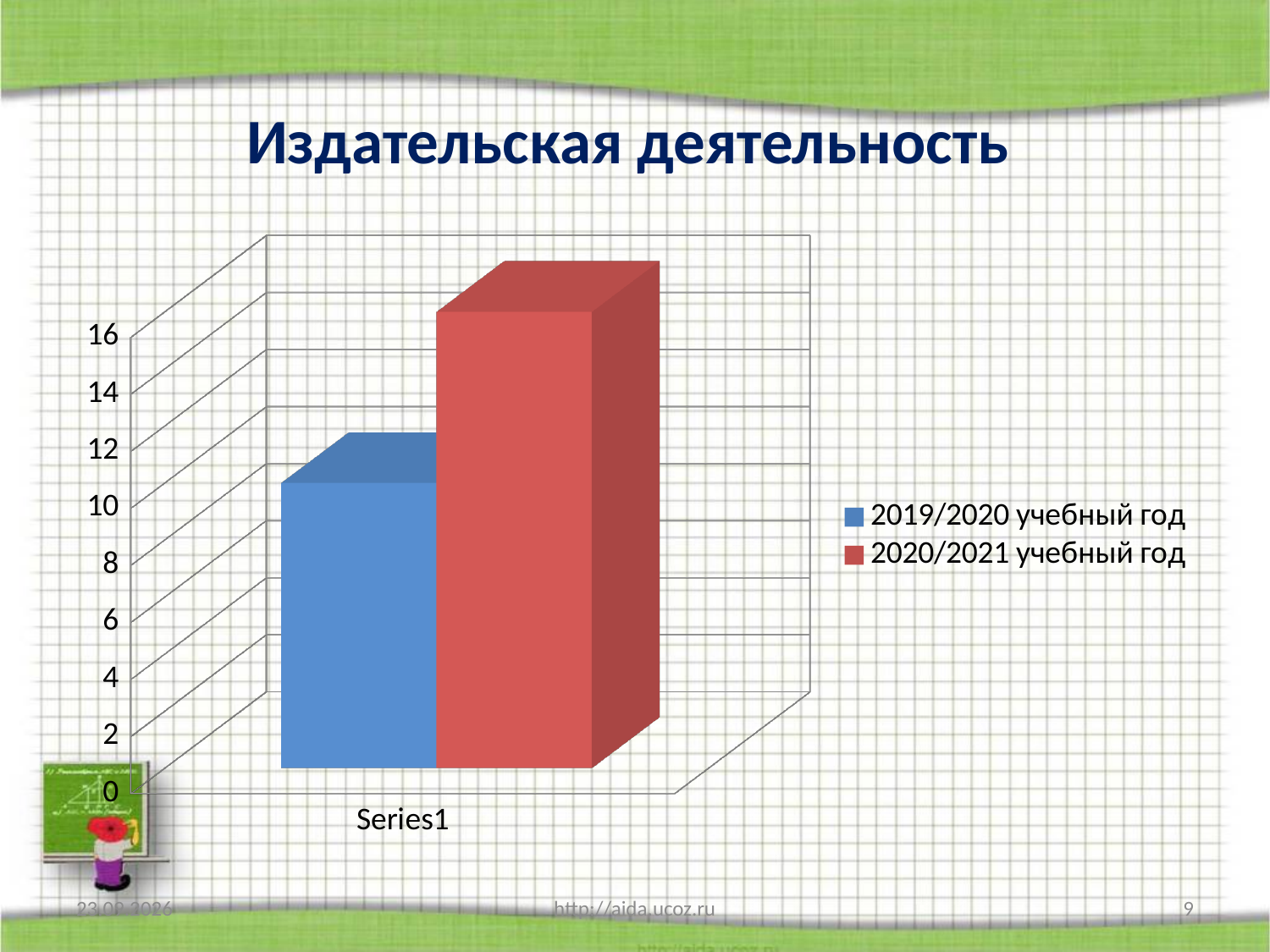
What colour is the bar for 2020/2021 учебный год? red Is the value for 2020/2021 учебный год greater or less than 12? greater What is the label of the category on the x axis? Series1 How many series does the legend list? 2 Which series has the higher bar, 2019/2020 учебный год or 2020/2021 учебный год? 2020/2021 учебный год What is the title of the chart? Издательская деятельность Is the value for 2019/2020 учебный год greater or less than 14? less How many categories are shown on the x axis? 1 Which series has the highest bar? 2020/2021 учебный год Is the value for 2019/2020 учебный год greater or less than 4? greater What kind of chart is shown on the slide? bar chart Which series has the lowest bar? 2019/2020 учебный год